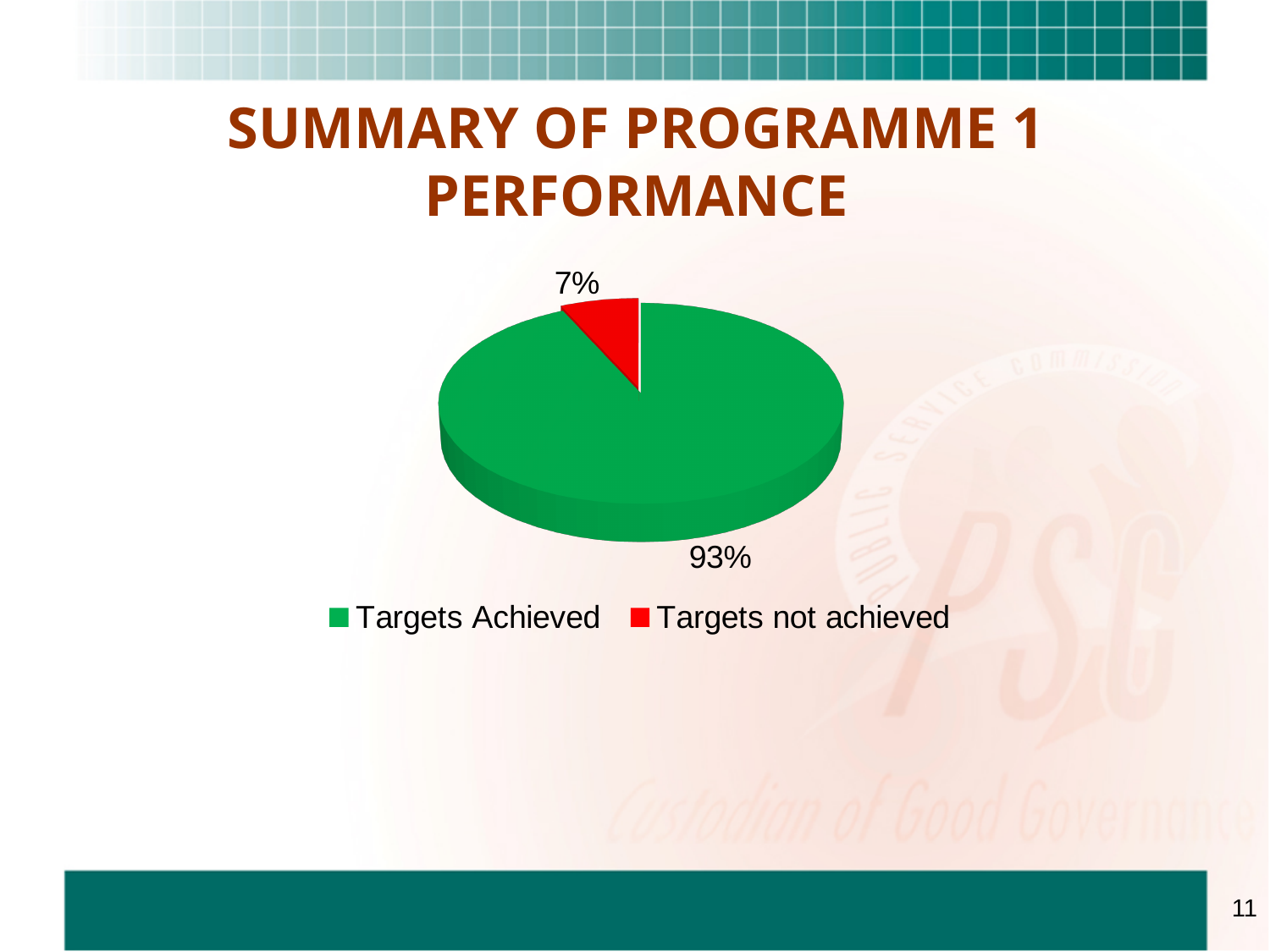
What share of the pie does the red slice represent? 7% What percentage of the pie chart is labelled Targets Achieved? 93% What colour is the slice for Targets Achieved? Green What is the title of the slide containing the chart? SUMMARY OF PROGRAMME 1 PERFORMANCE Which category has the largest slice of the pie chart? Targets Achieved How many categories does the pie chart show? 2 What kind of chart is shown on the slide? Pie chart How many entries does the legend list? 2 Which category has the smallest slice of the pie chart? Targets not achieved Which is larger, the share for Targets Achieved or the share for Targets not achieved? Targets Achieved What is the difference in percentage points between Targets Achieved and Targets not achieved? 86 What percentage of the pie chart is labelled Targets not achieved? 7%